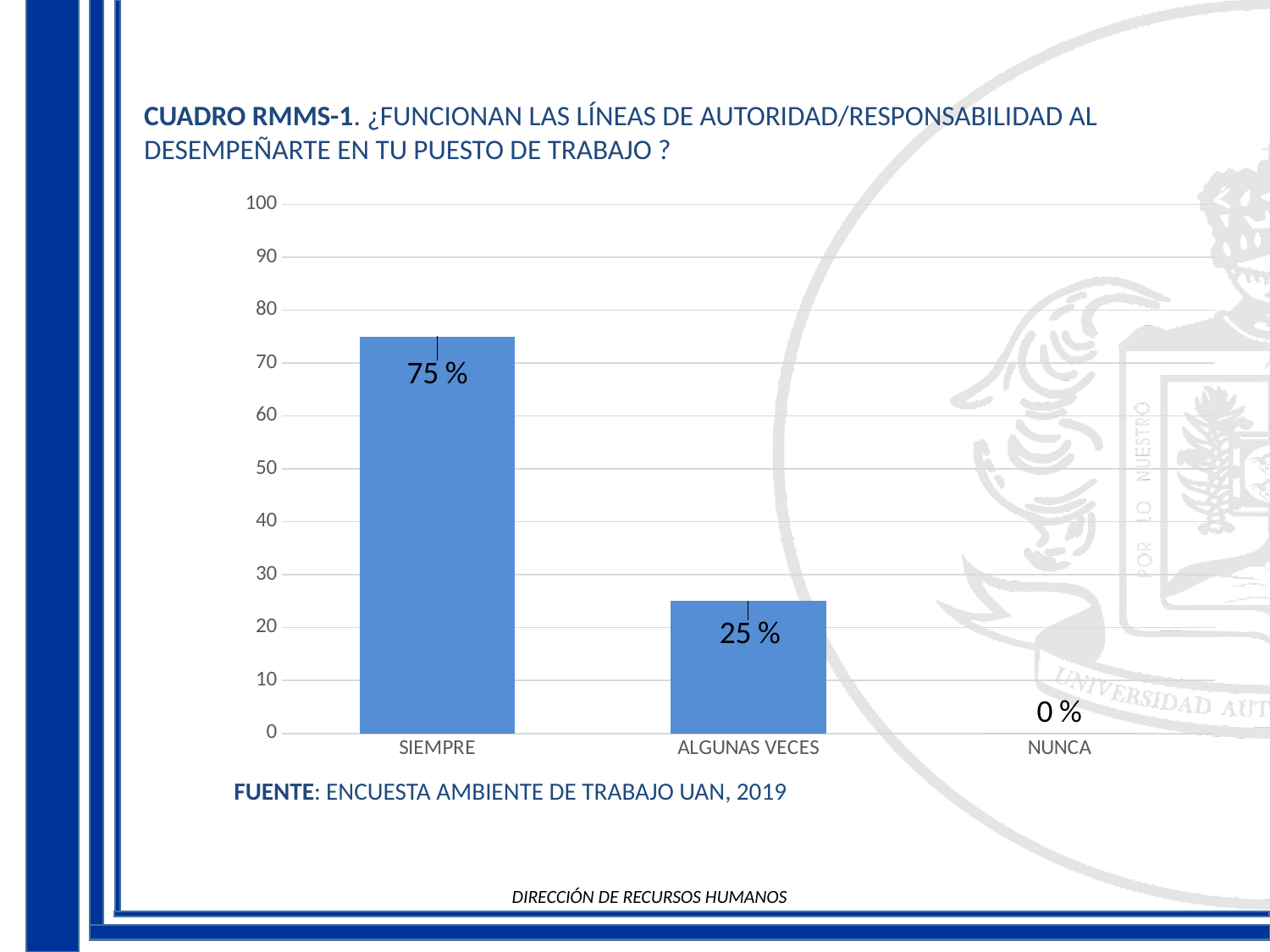
Is the value for SIEMPRE greater or less than 70? greater Do the values rise or fall from left to right along the x axis? fall Which category has the highest value? SIEMPRE Which category has the lowest value? NUNCA Which is larger, the value for ALGUNAS VECES or the value for NUNCA? ALGUNAS VECES What is the value for ALGUNAS VECES? 25 % How many categories are shown on the x axis? 3 Is the value for ALGUNAS VECES greater or less than 30? less What is the value for SIEMPRE? 75 % What is the difference between the values for SIEMPRE and ALGUNAS VECES? 50 % What is the value for NUNCA? 0 % What kind of chart is shown on the slide? bar chart